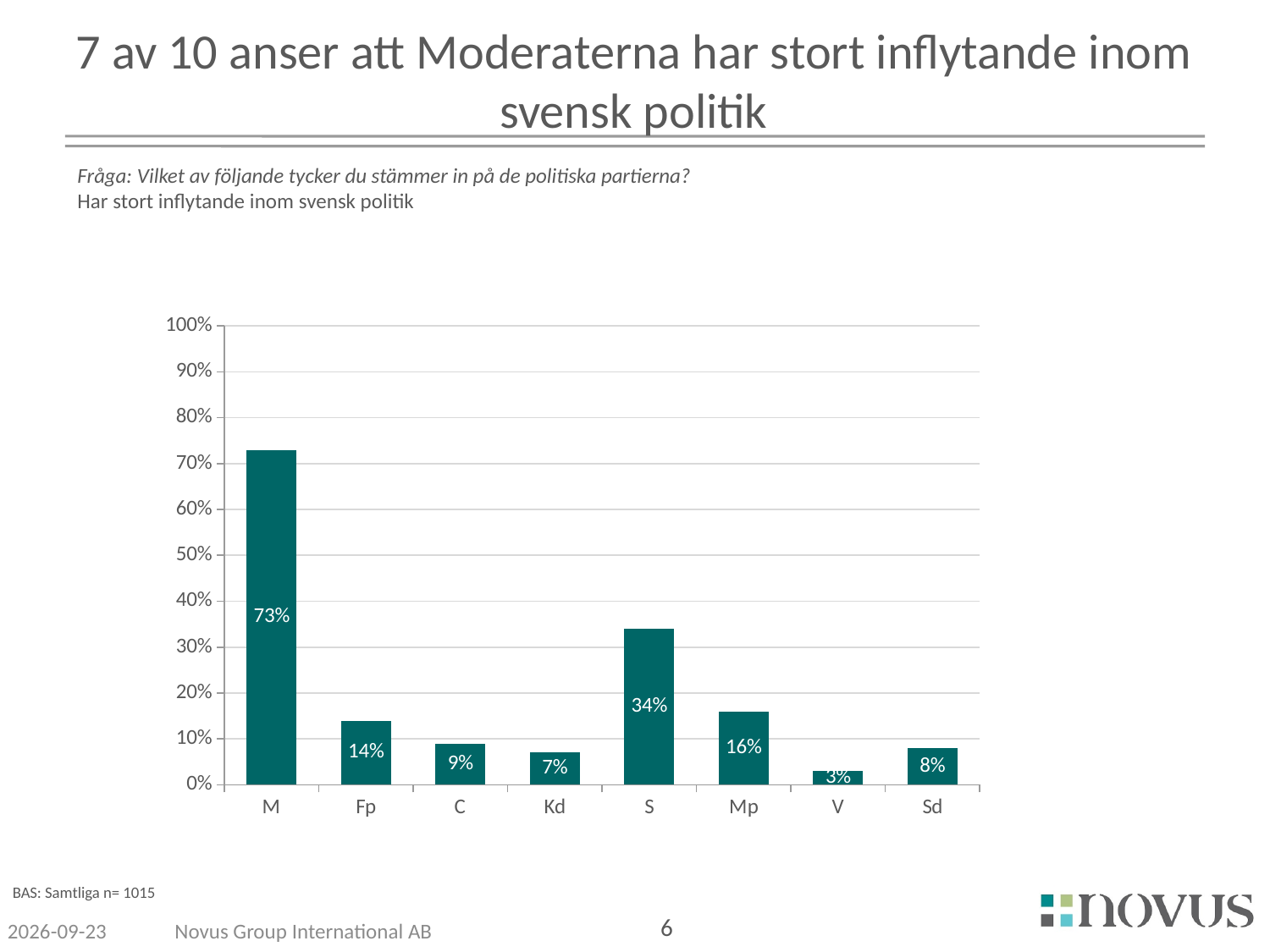
Which is larger, the value for Mp or the value for C? Mp What is the value for V? 3% Which party has the highest value? M What is the value for S? 34% What is the value for Mp? 16% What is the difference between the values for Fp and Kd? 7% What is the value for M? 73% Is the value for M greater or less than 70%? greater What is the difference between the values for M and S? 39% Which party has the lowest value? V What kind of chart is shown on the slide? bar chart How many parties are shown on the x axis? 8